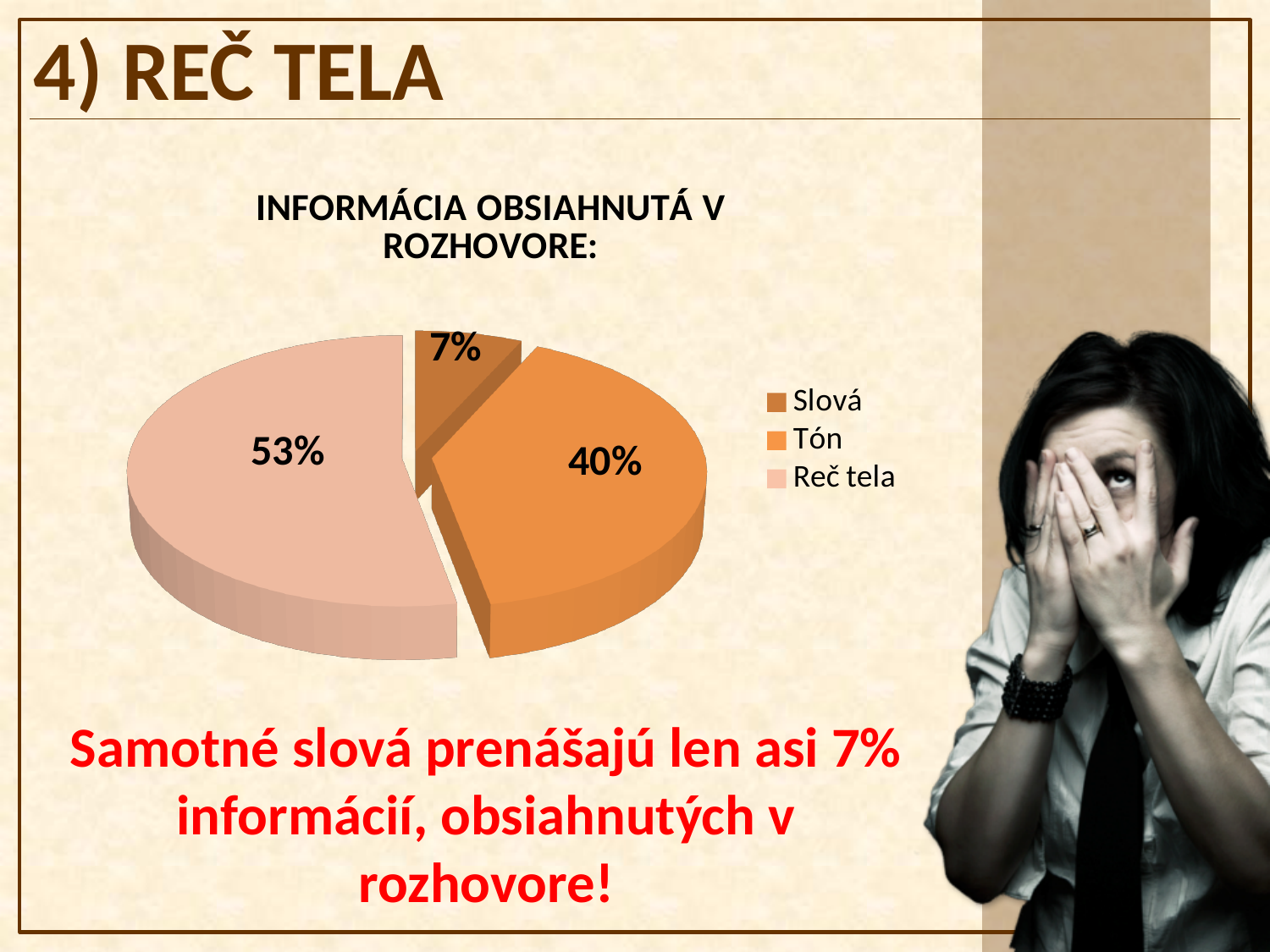
What is the difference between the Reč tela share and the Tón share? 13% What percentage does the Tón slice represent? 40% What is the difference between the Tón share and the Slová share? 33% How many slices does the pie chart have? 3 Which is larger, the Tón slice or the Slová slice? Tón Which category has the smallest share of the pie? Slová What percentage does the Reč tela slice represent? 53% Which category has the largest share of the pie? Reč tela What is the title of the chart? INFORMÁCIA OBSIAHNUTÁ V ROZHOVORE: How many entries does the legend list? 3 What percentage does the Slová slice represent? 7% What type of chart is shown on the slide? Pie chart